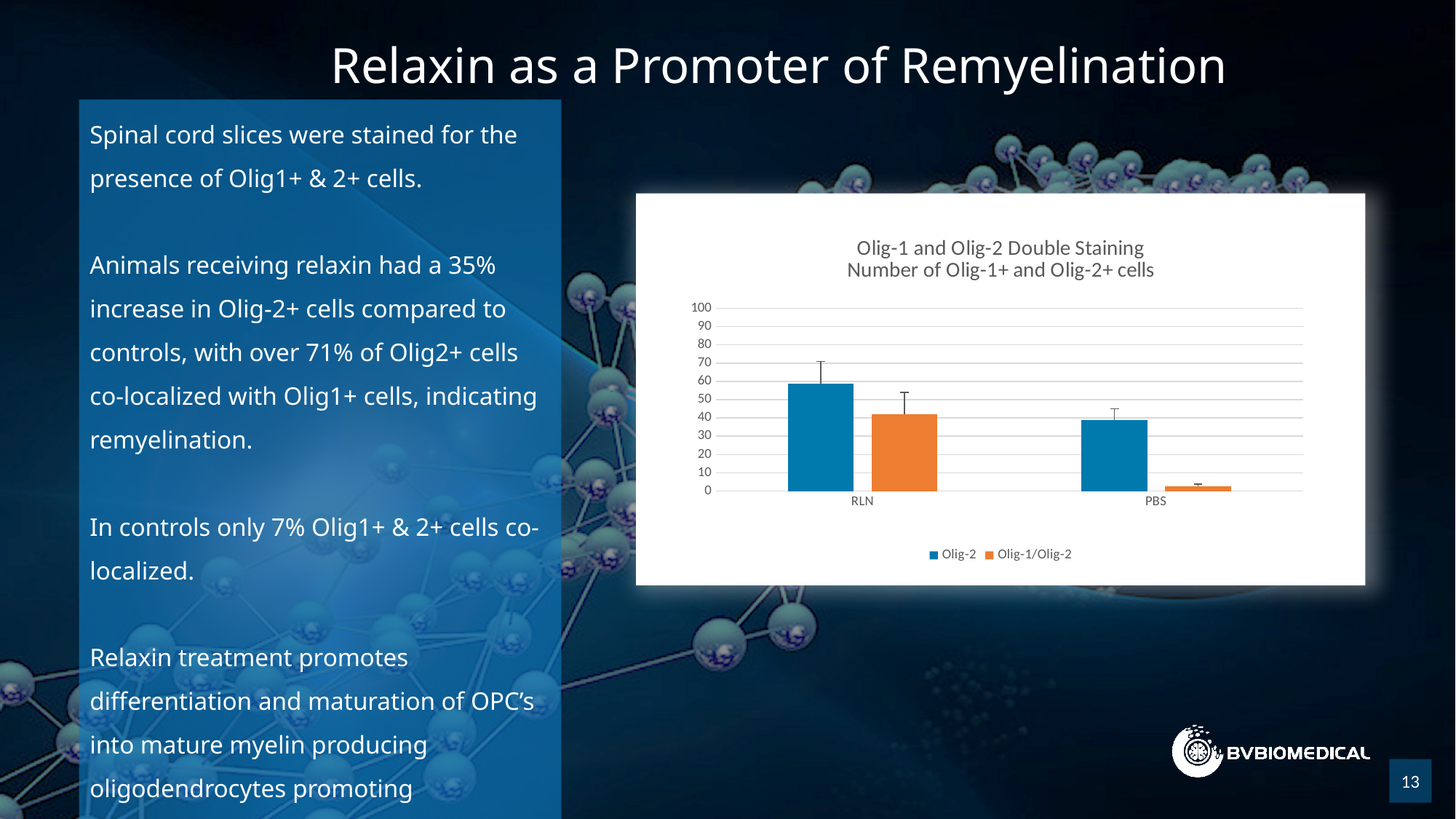
Which category has the highest Olig-1/Olig-2 value? RLN Is the Olig-2 value for PBS greater or less than 50? less How many series does the chart's legend list? 2 What kind of chart is shown on the slide? Bar chart Is the Olig-2 value for RLN greater or less than 50? greater Is the Olig-1/Olig-2 value for PBS greater or less than 10? less What is the title of the chart? Olig-1 and Olig-2 Double Staining Number of Olig-1+ and Olig-2+ cells Which category has the lowest Olig-1/Olig-2 value? PBS Which series is shown in orange in the chart? Olig-1/Olig-2 How many categories are shown on the x axis of the chart? 2 Which category has the higher Olig-2 value, RLN or PBS? RLN